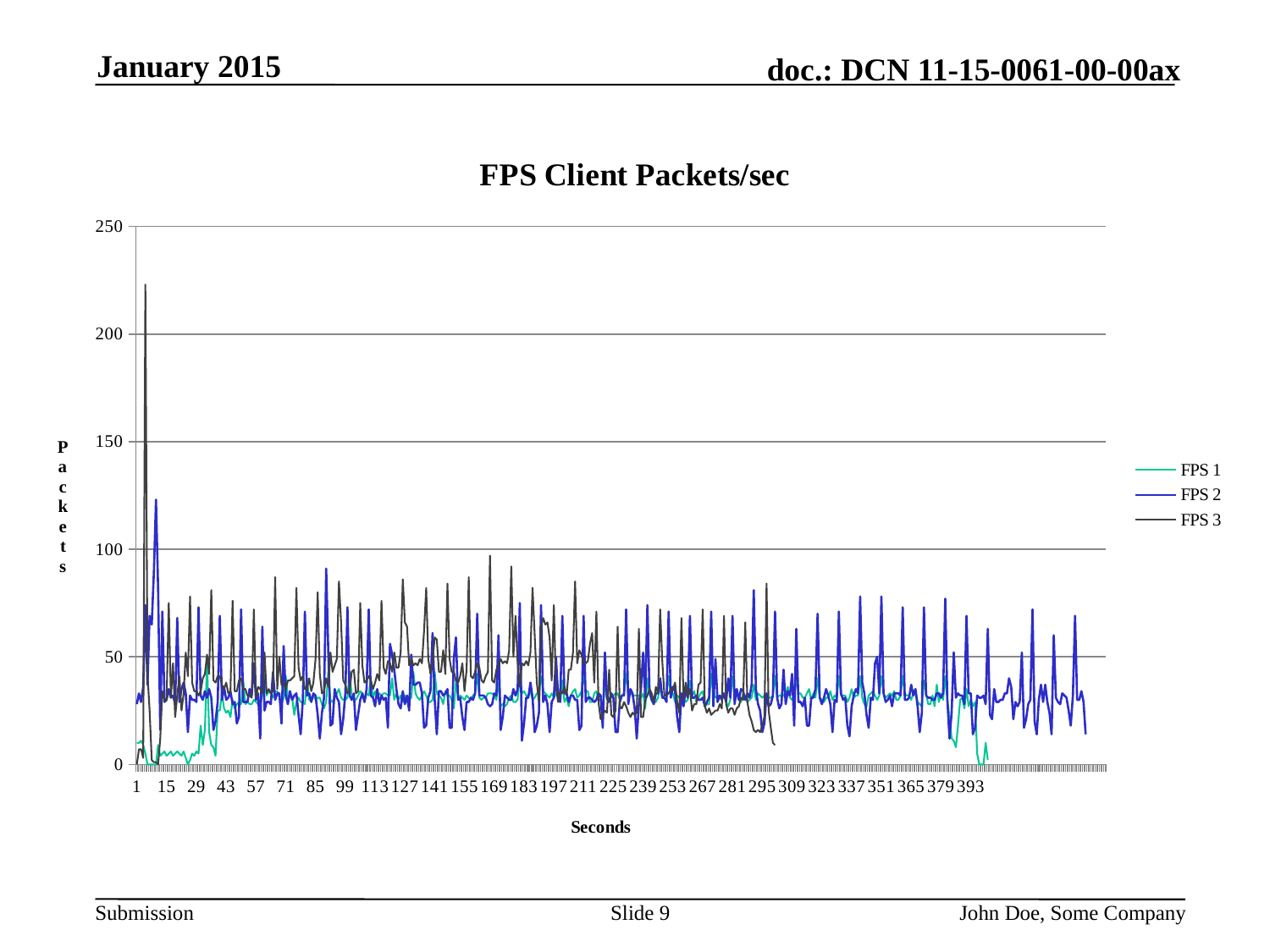
What is the title of the chart? FPS Client Packets/sec What is the highest value shown on the vertical axis? 250 What is the first label shown on the horizontal axis? 1 Is the highest value reached by FPS 1 greater or less than 100? less Which series reaches the highest peak value on the chart? FPS 3 How many series does the legend list? 3 Which series reaches a higher peak, FPS 2 or FPS 3? FPS 3 Is the highest value reached by FPS 2 greater or less than 150? less What kind of chart is shown on the slide? line chart What are the names of the series listed in the legend? FPS 1, FPS 2, FPS 3 Which series reaches a higher peak, FPS 1 or FPS 2? FPS 2 Is the highest value reached by FPS 3 greater or less than 200? greater